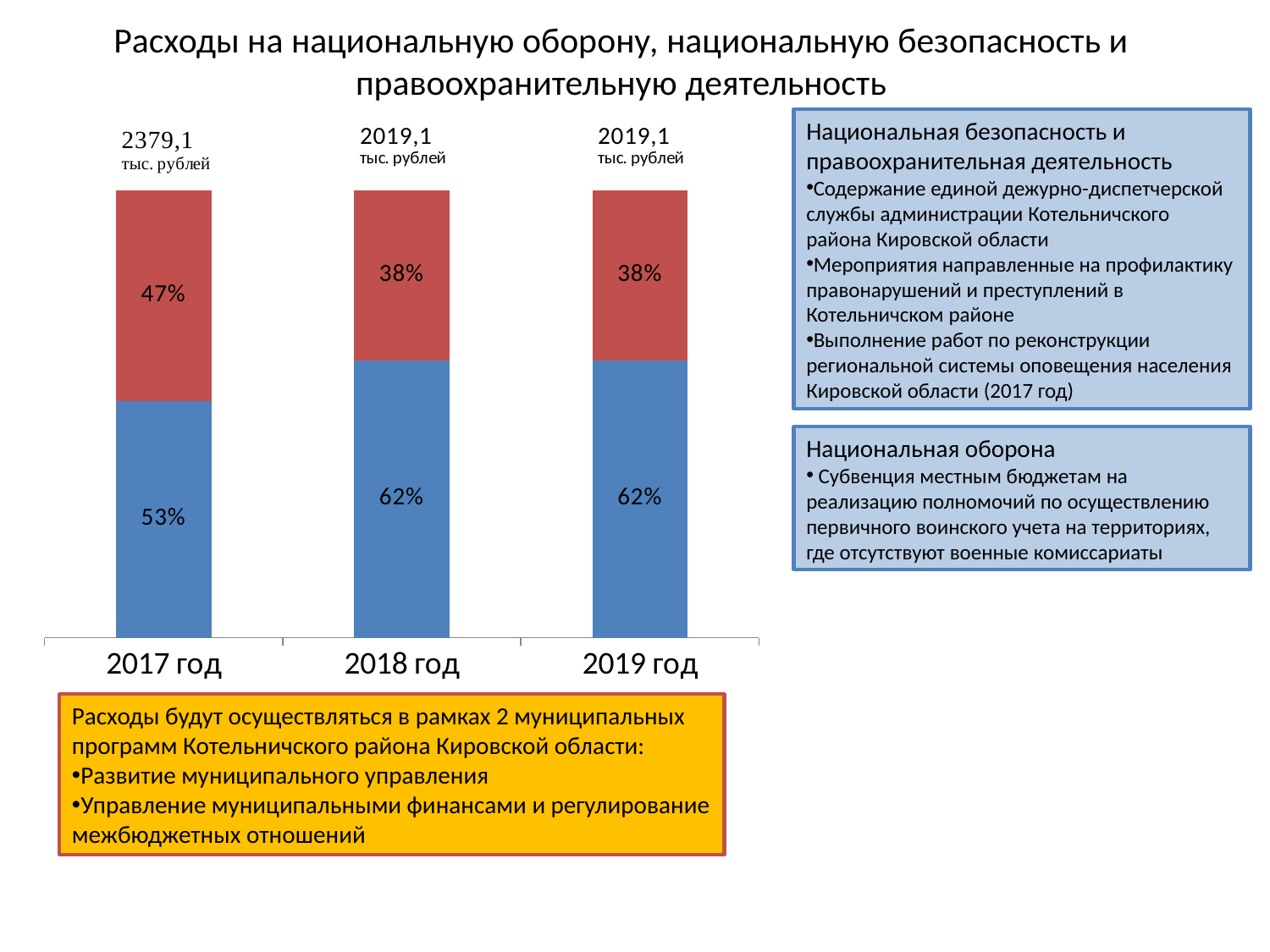
Which is larger: the blue segment percentage for 2017 год or for 2018 год? 2018 год How many years (categories) are shown on the x axis of the chart? 3 What total amount is printed above the 2018 год bar? 2019,1 тыс. рублей What percentage is shown in the red segment of the 2019 год bar? 38% What is the difference between the blue and red segment percentages in the 2018 год bar? 24% What percentage is shown in the blue segment of the 2018 год bar? 62% What total amount is printed above the 2017 год bar? 2379,1 тыс. рублей What kind of chart is shown on the slide? Stacked bar chart Does the red segment's share rise or fall from 2017 год to 2018 год? Fall Which year has the highest total amount printed above its bar? 2017 год What percentage is shown in the red segment of the 2017 год bar? 47% What percentage is shown in the blue segment of the 2017 год bar? 53%